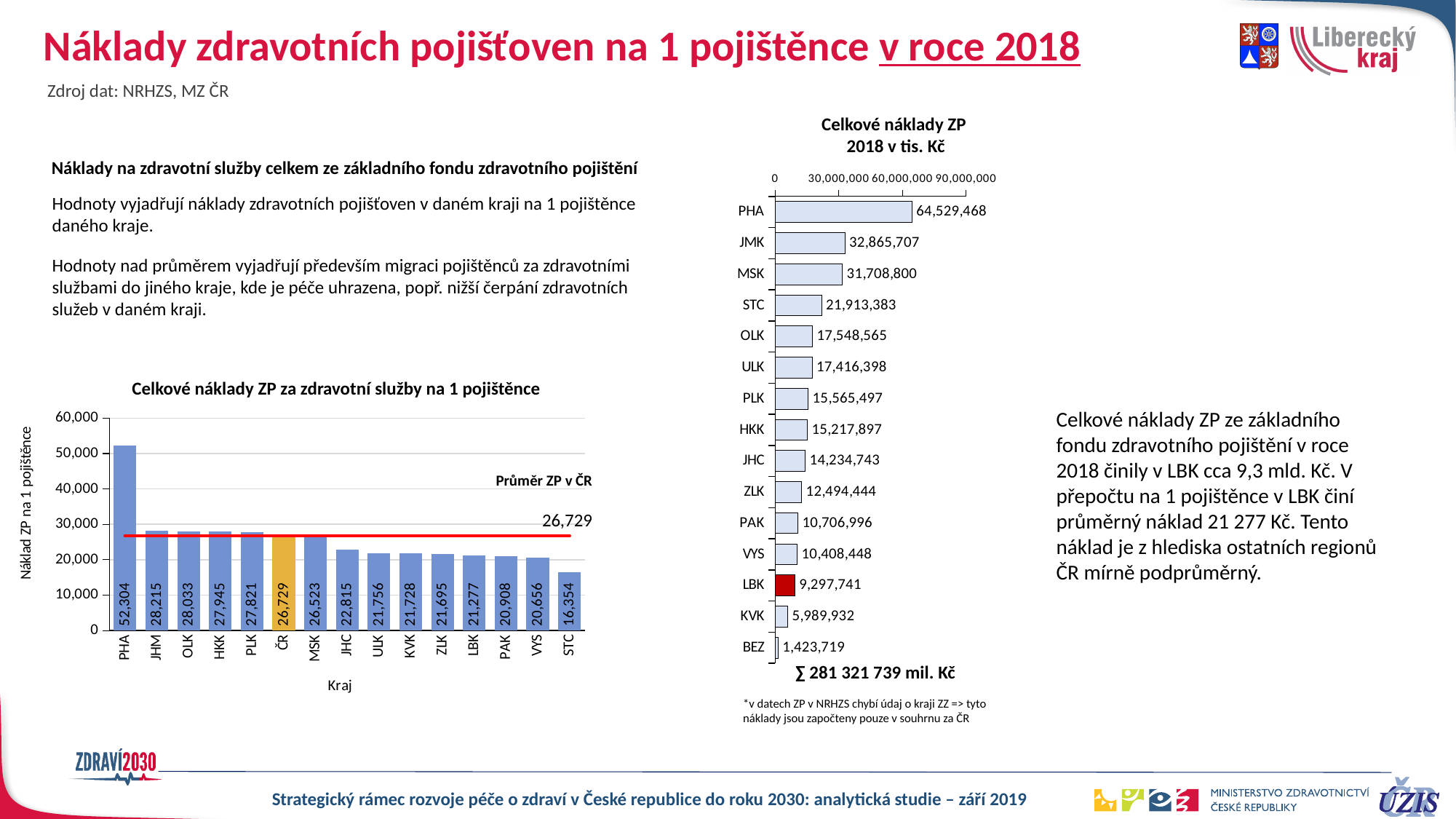
In the chart 'Celkové náklady ZP 2018 v tis. Kč', which region has the lowest value? BEZ In the chart 'Celkové náklady ZP 2018 v tis. Kč', which is larger, the value for JMK or the value for MSK? JMK In the chart 'Celkové náklady ZP za zdravotní služby na 1 pojištěnce', which region has the lowest value? STC In the chart 'Celkové náklady ZP 2018 v tis. Kč', what is the difference between the values for PHA and JMK? 31,663,761 What kind of chart is 'Celkové náklady ZP za zdravotní služby na 1 pojištěnce'? Bar chart In the chart 'Celkové náklady ZP za zdravotní služby na 1 pojištěnce', what is the value for LBK? 21,277 In the chart 'Celkové náklady ZP za zdravotní služby na 1 pojištěnce', which region has the highest value? PHA In the chart 'Celkové náklady ZP 2018 v tis. Kč', what is the value for LBK? 9,297,741 In the chart 'Celkové náklady ZP za zdravotní služby na 1 pojištěnce', what is the value shown for the ČR average (Průměr ZP v ČR)? 26,729 In the chart 'Celkové náklady ZP za zdravotní služby na 1 pojištěnce', what is the difference between the values for PHA and STC? 35,950 In the chart 'Celkové náklady ZP 2018 v tis. Kč', which bar is highlighted in red? LBK How many bars are shown in the chart 'Celkové náklady ZP 2018 v tis. Kč'? 15